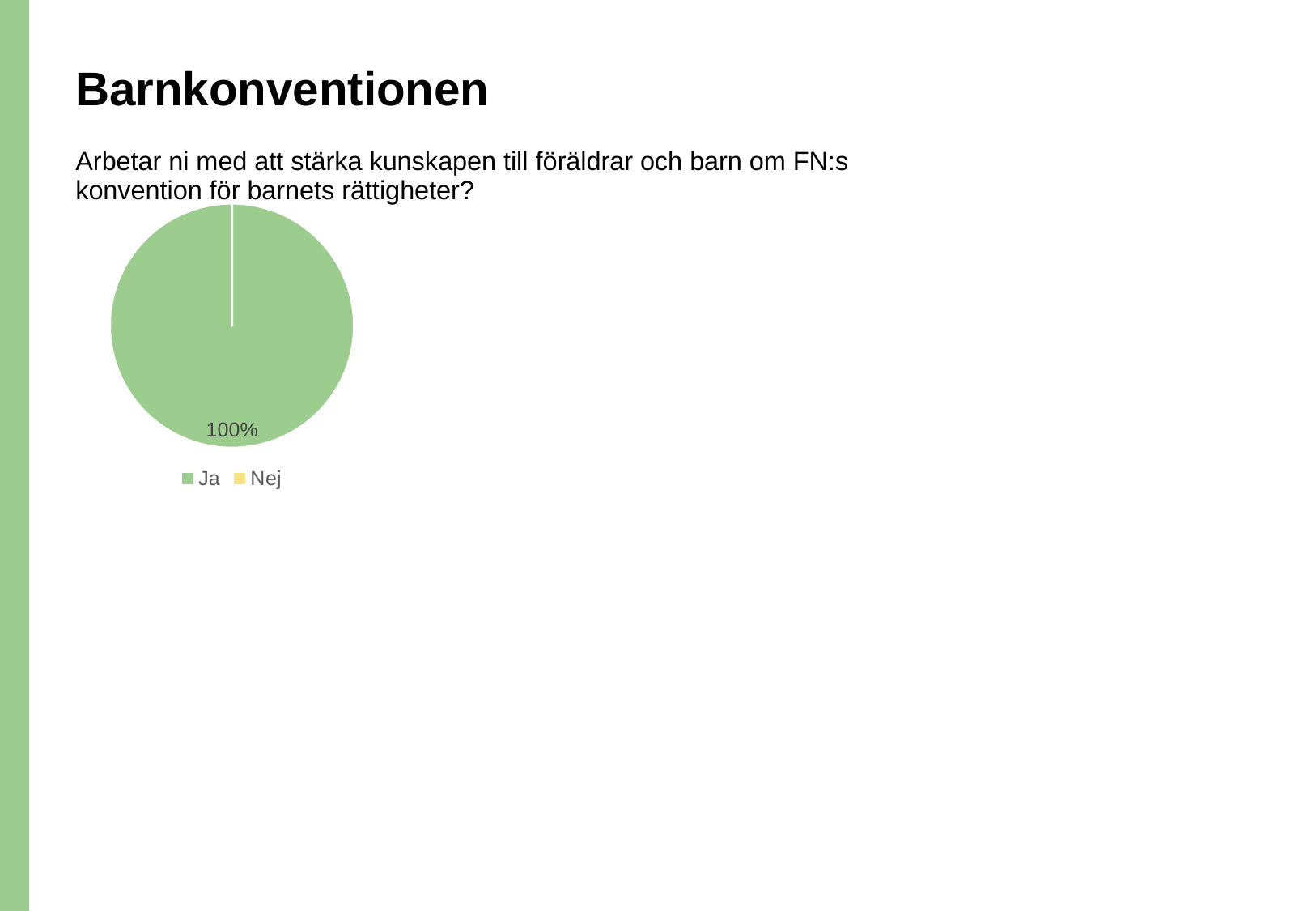
What colour is used for "Ja" in the chart? green Which category has the smallest share of the pie? Nej What share of the pie does "Ja" represent? 100% What kind of chart is shown on the slide? pie chart Which category has the largest share of the pie? Ja Which is larger, the share for "Ja" or the share for "Nej"? Ja How many entries does the legend list? 2 What is the only data label printed on the pie chart? 100% What colour is used for "Nej" in the legend? yellow